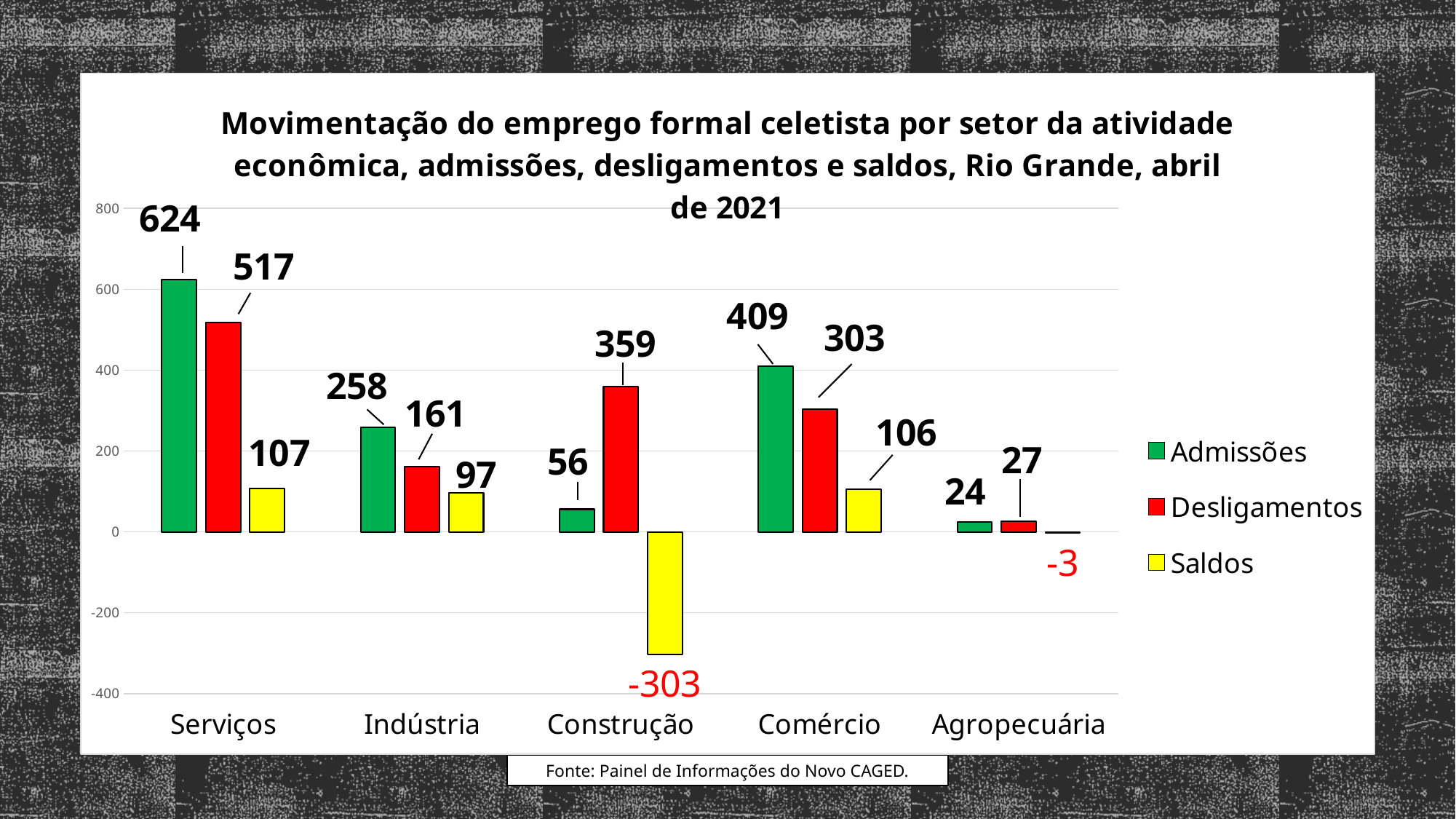
What kind of chart is shown on the slide? Bar chart What is the Saldos value for Construção? -303 Which sector has the highest Admissões value? Serviços How many sectors are shown on the x axis? 5 How many series does the legend list? 3 What is the Saldos value for Agropecuária? -3 What is the difference between Admissões and Desligamentos for Indústria? 97 Which is larger for Construção, Admissões or Desligamentos? Desligamentos Which colour represents the Saldos series in the legend? Yellow Which sector has the lowest Desligamentos value? Agropecuária What is the Admissões value for Serviços? 624 What is the Desligamentos value for Comércio? 303